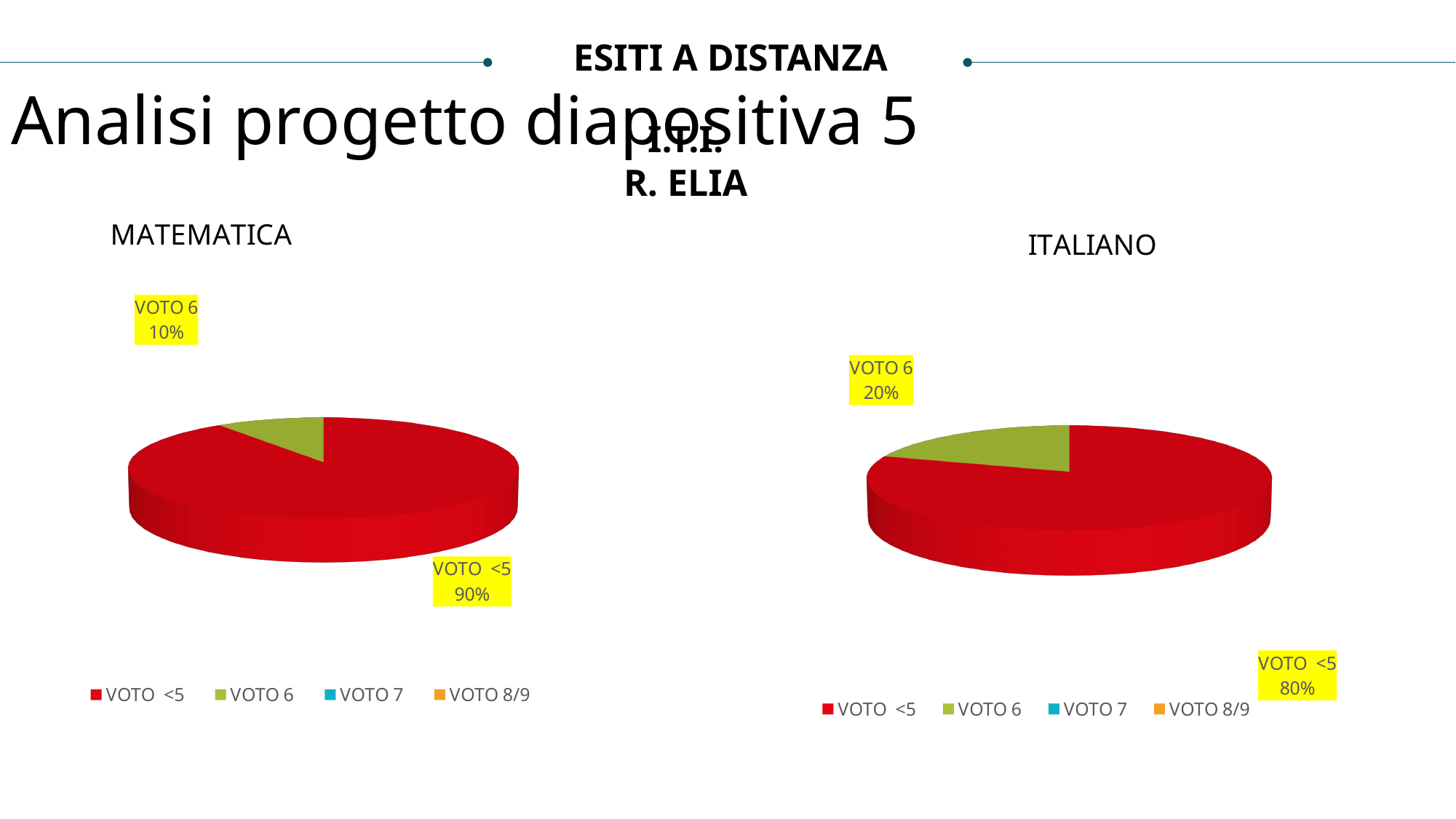
In the ITALIANO chart, which category has the largest slice? VOTO <5 How many entries does the legend of the ITALIANO chart list? 4 In the MATEMATICA chart, what share of the pie is VOTO <5? 90% What kind of chart is the MATEMATICA chart? Pie chart In the MATEMATICA chart, what colour is the VOTO <5 slice? Red Which chart has the larger VOTO 6 share, MATEMATICA or ITALIANO? ITALIANO In the ITALIANO chart, what share of the pie is VOTO 6? 20% In the MATEMATICA chart, what share of the pie is VOTO 6? 10% In the ITALIANO chart, what is the difference between the VOTO <5 share and the VOTO 6 share? 60% In the MATEMATICA chart, what is the difference between the VOTO <5 share and the VOTO 6 share? 80% In the MATEMATICA chart, which category has the largest slice? VOTO <5